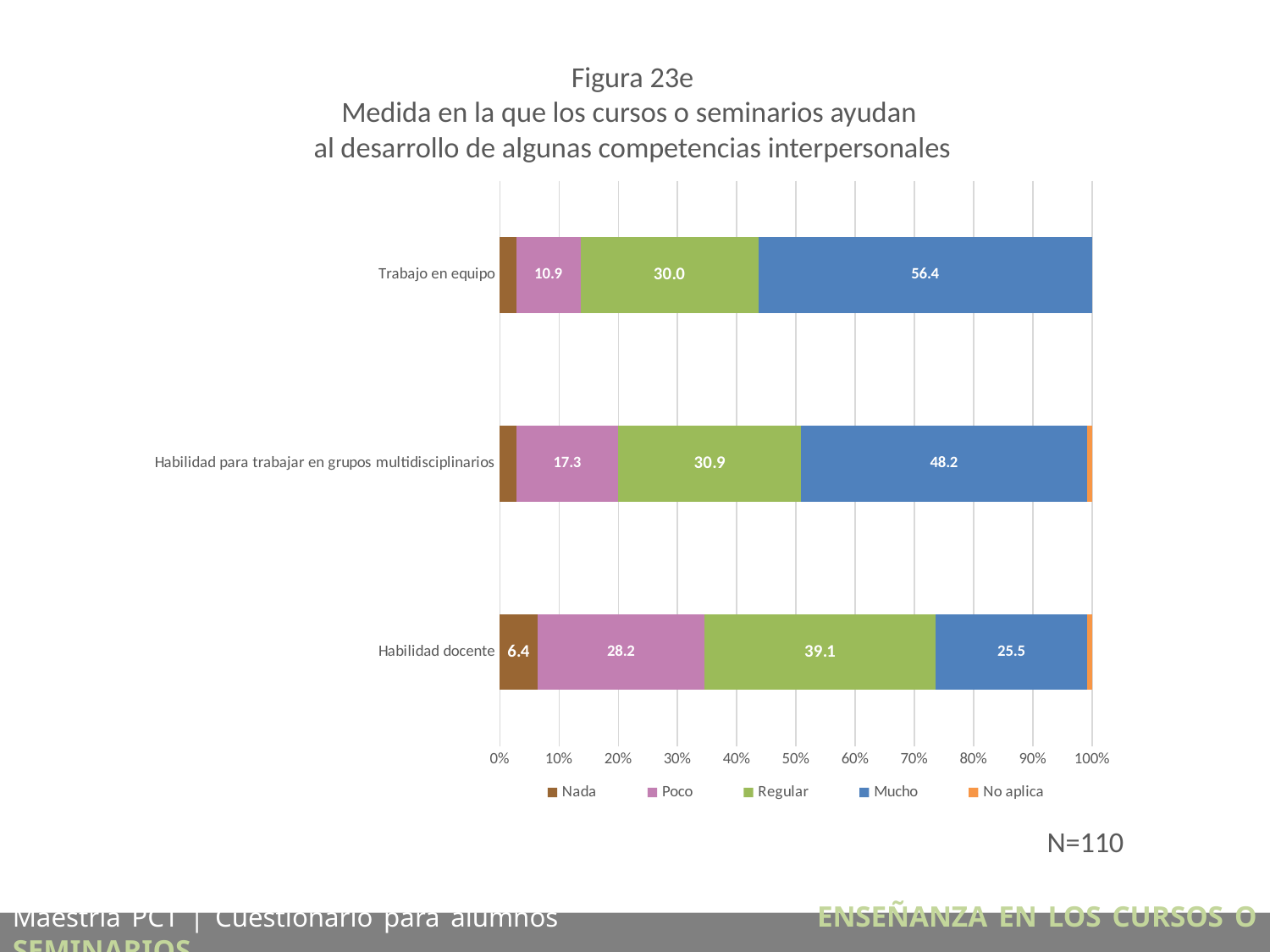
Is the "Nada" value for "Trabajo en equipo" greater or less than 10%? less How many categories are shown on the chart? 3 What is the value of "Mucho" for "Trabajo en equipo"? 56.4 What type of chart is shown on the slide? Stacked bar chart What is the difference between the "Mucho" values for "Trabajo en equipo" and "Habilidad docente"? 30.9 What is the value of "Nada" for "Habilidad docente"? 6.4 What is the value of "Poco" for "Habilidad docente"? 28.2 What is the value of "Regular" for "Habilidad para trabajar en grupos multidisciplinarios"? 30.9 Which category has the lowest value for "Poco"? Trabajo en equipo Which is larger: the "Regular" value for "Habilidad docente" or for "Trabajo en equipo"? Habilidad docente Which category has the highest value for "Mucho"? Trabajo en equipo How many series does the legend list? 5